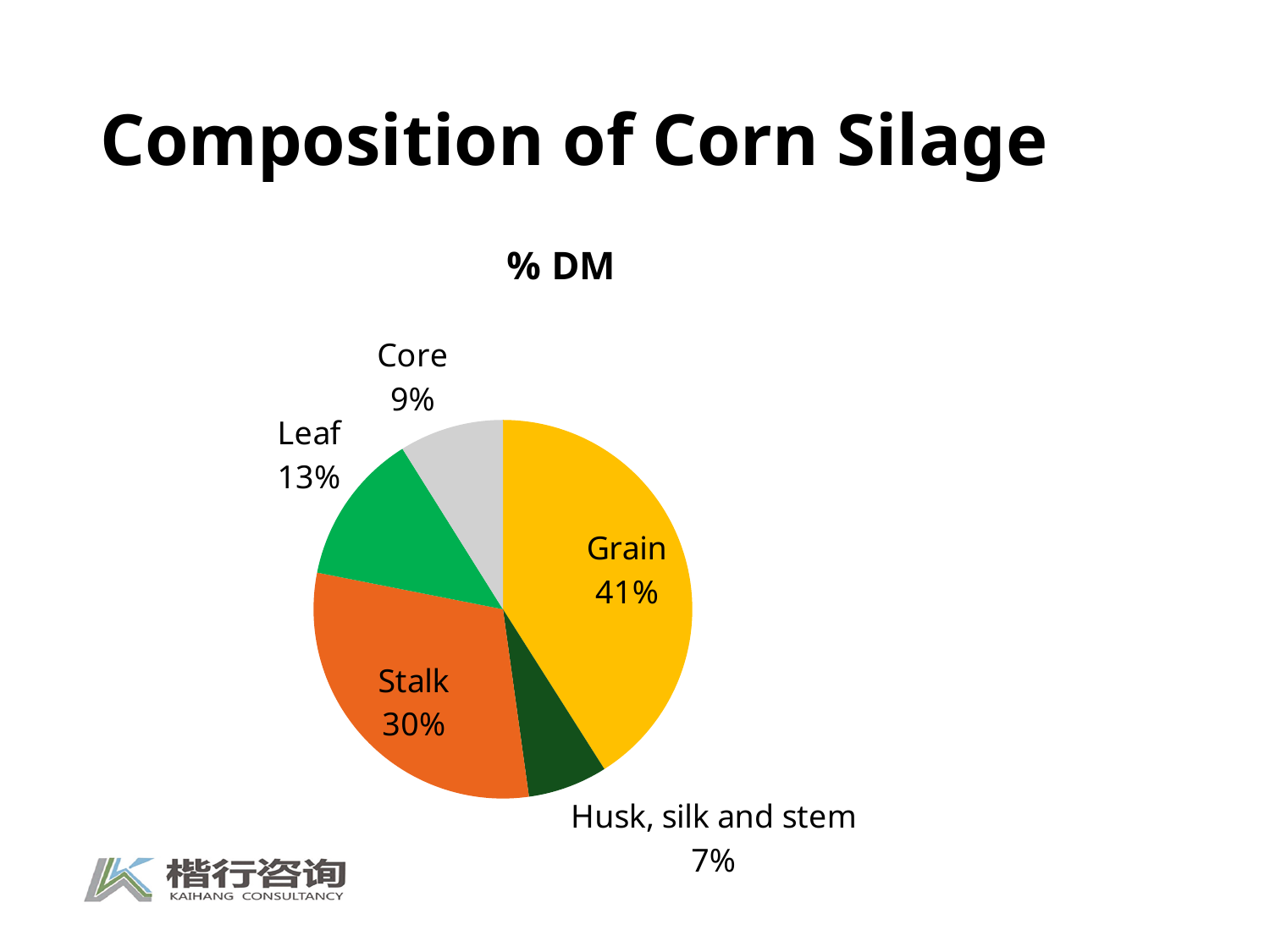
How many slices does the pie chart have? 5 Which is larger, the share for Leaf or the share for Core? Leaf What is the difference between the Grain and Stalk percentages? 11% What percentage is shown for Stalk? 30% What type of chart is shown on the slide? pie chart What percentage is shown for Husk, silk and stem? 7% Which component has the largest share of the pie? Grain Which component has the smallest share of the pie? Husk, silk and stem What percentage is shown for Leaf? 13% What percentage is shown for Core? 9% What percentage of corn silage dry matter is Grain? 41% What is the chart's title? % DM